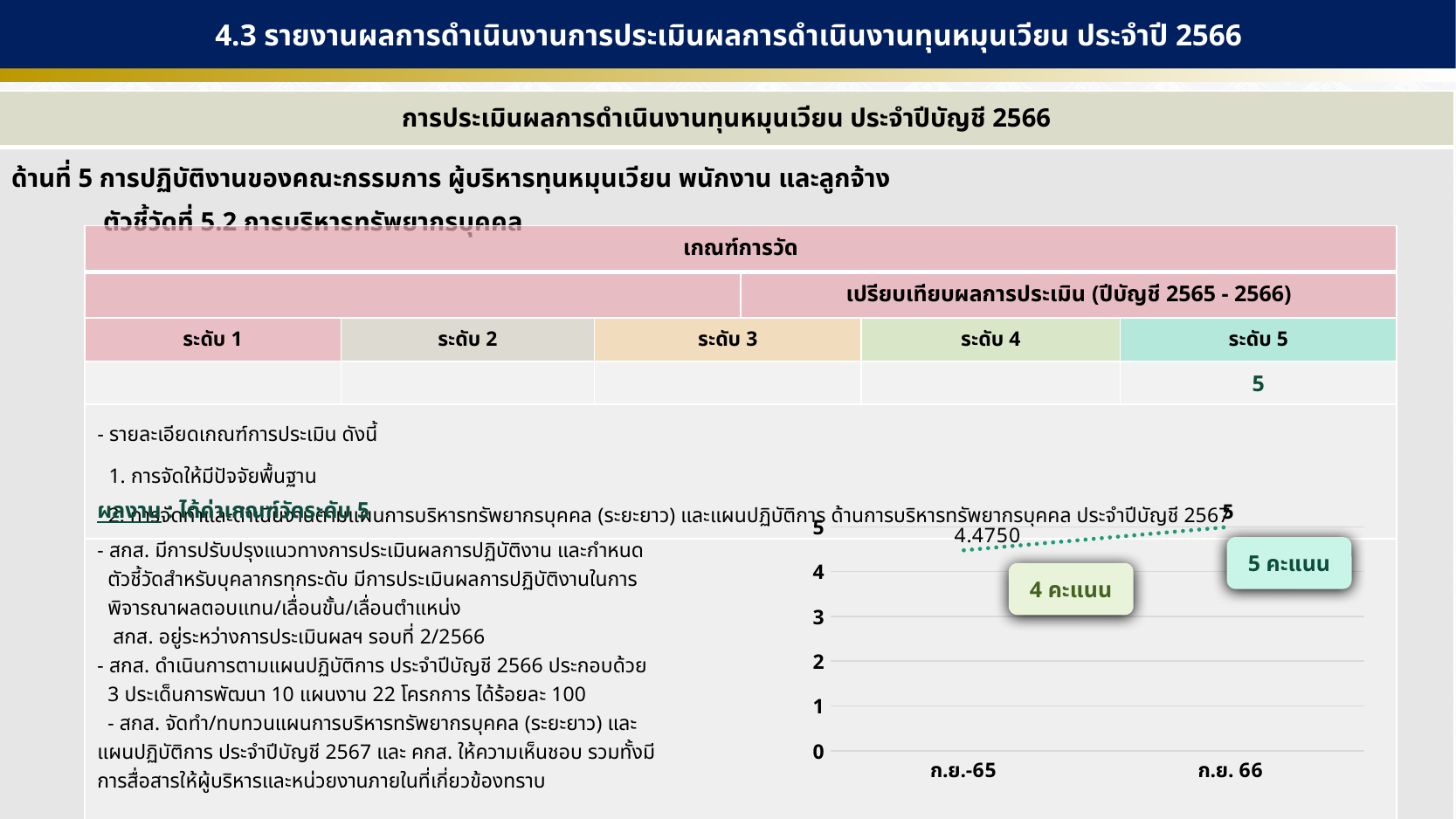
Which category has the higher value in the chart, ก.ย.-65 or ก.ย. 66? ก.ย. 66 What kind of chart is shown on the slide? line chart Is the value for ก.ย.-65 greater or less than 4? greater What text is shown in the callout box next to the ก.ย. 66 point? 5 คะแนน What is the value plotted for ก.ย. 66 in the chart? 5 What is the maximum value shown on the chart's vertical axis? 5 How many data points are plotted in the chart? 2 What is the difference between the values for ก.ย. 66 and ก.ย.-65 in the chart? 0.525 Do the values rise or fall from ก.ย.-65 to ก.ย. 66 in the chart? rise Which category has the lowest value in the chart? ก.ย.-65 What is the value plotted for ก.ย.-65 in the chart? 4.4750 Which category has the highest value in the chart? ก.ย. 66